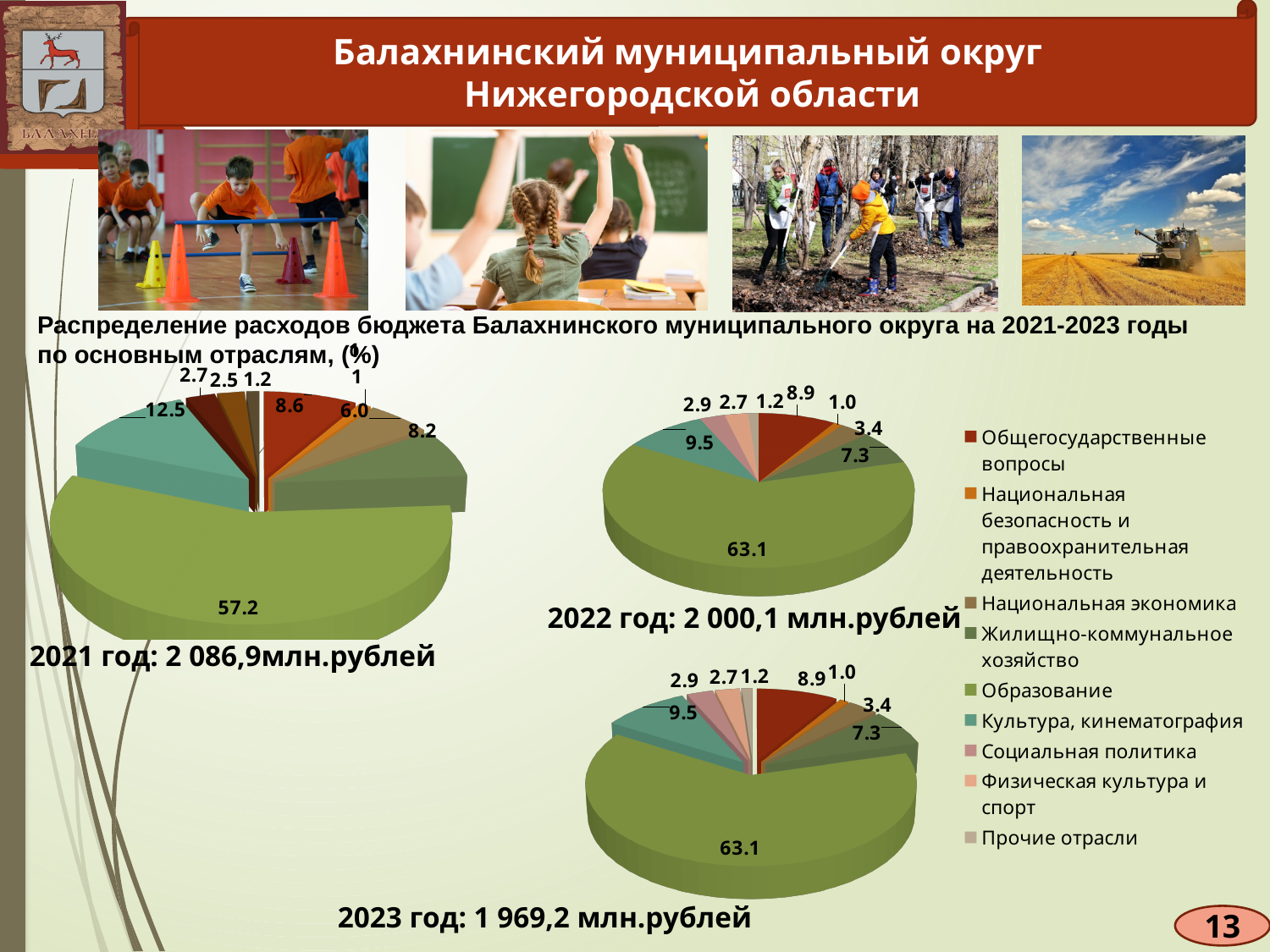
How many categories does the legend list for the pie charts? 9 In the 2022 pie chart, what is the value for Общегосударственные вопросы? 8.9 What is the difference between the Образование share in the 2022 pie chart (63.1) and the largest slice in the 2021 pie chart (57.2)? 5.9 What total budget amount is given in the caption of the 2022 pie chart? 2 000,1 млн.рублей In the 2023 pie chart, what is the value for Социальная политика? 2.9 In the 2021 pie chart, what is the value of the largest slice? 57.2 In the 2022 pie chart, what is the value for Образование? 63.1 How many slices does the 2023 pie chart have? 9 In the 2022 pie chart, which category has the smallest slice? Национальная безопасность и правоохранительная деятельность In the 2022 pie chart, which is larger: Жилищно-коммунальное хозяйство or Национальная экономика? Жилищно-коммунальное хозяйство In the 2023 pie chart, what is the value for Культура, кинематография? 9.5 What kind of charts are shown on the slide? Pie charts